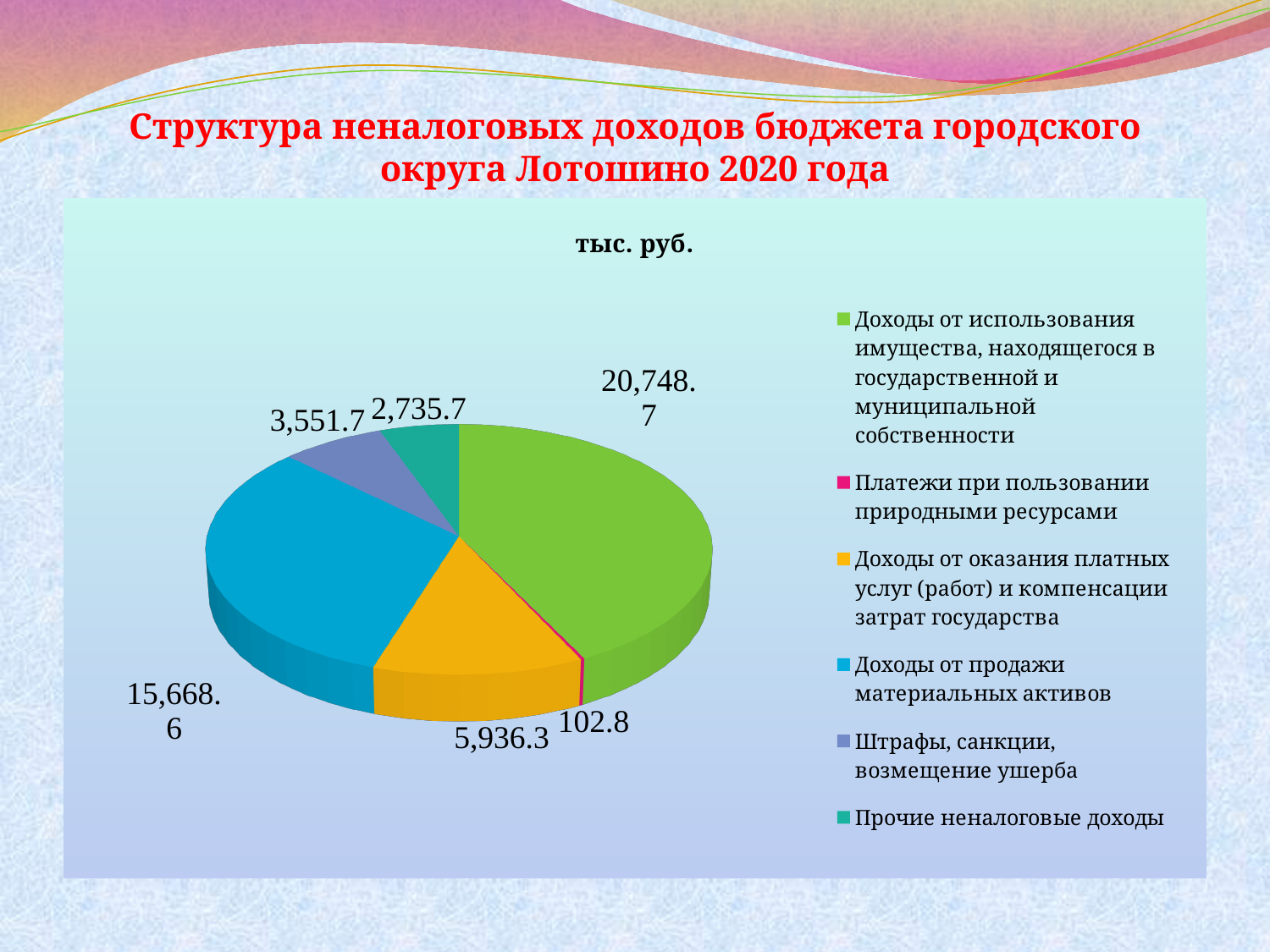
What is the value for "Штрафы, санкции, возмещение ущерба"? 3,551.7 What is the difference between the values for "Доходы от использования имущества" and "Доходы от продажи материальных активов"? 5,080.1 What is the value for "Доходы от продажи материальных активов"? 15,668.6 Which category has the largest slice of the pie? Доходы от использования имущества, находящегося в государственной и муниципальной собственности What is the value for "Доходы от использования имущества, находящегося в государственной и муниципальной собственности"? 20,748.7 What type of chart is shown on the slide? Pie chart Which category has the smallest slice of the pie? Платежи при пользовании природными ресурсами Which is larger: "Доходы от оказания платных услуг (работ) и компенсации затрат государства" or "Прочие неналоговые доходы"? Доходы от оказания платных услуг (работ) и компенсации затрат государства What is the chart's title? тыс. руб. What is the value for "Платежи при пользовании природными ресурсами"? 102.8 What colour is the slice for "Прочие неналоговые доходы"? Teal How many categories does the legend list? 6